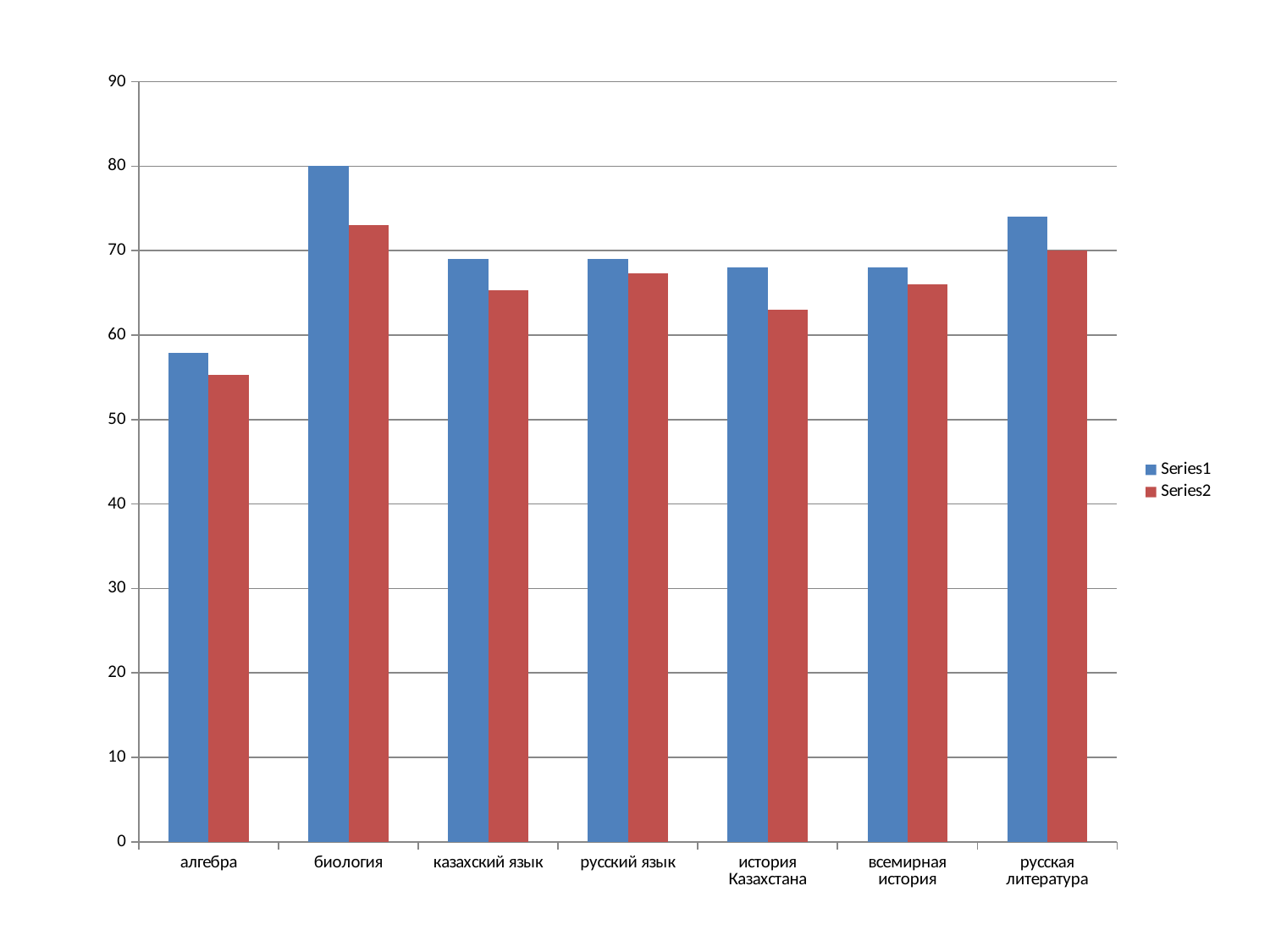
Is the Series2 value for биология greater or less than 70? greater How many series does the legend list? 2 What is the Series1 value for биология? 80 What kind of chart is shown on the slide? bar chart What is the Series2 value for русская литература? 70 Which category has the lowest Series1 value? алгебра Which category has the highest Series1 value? биология Is the Series1 value for алгебра greater or less than 60? less For биология, which is larger: Series1 or Series2? Series1 Which category has the lowest Series2 value? алгебра What colour are the Series2 bars? red How many categories are shown on the x axis? 7